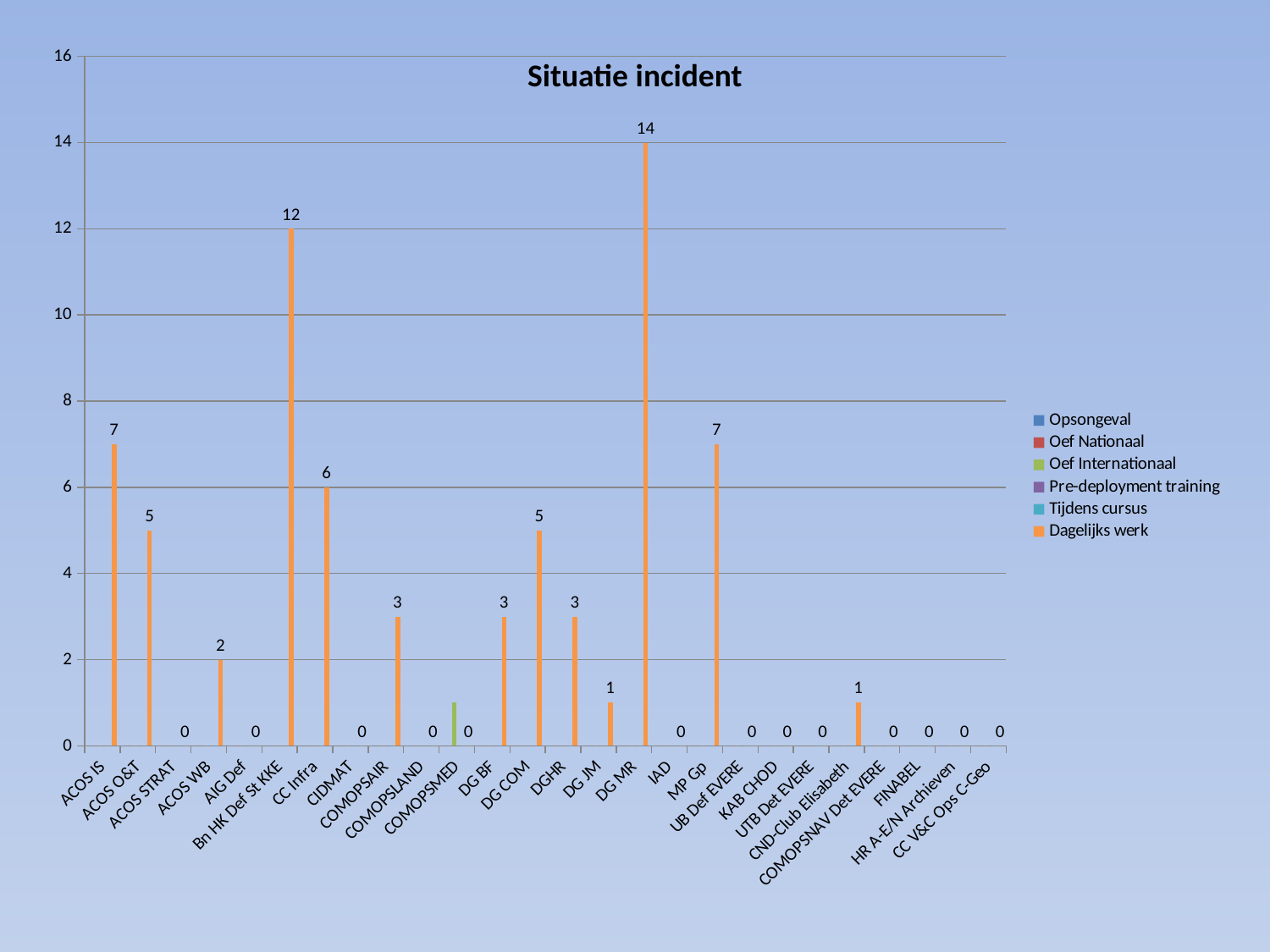
What is the title of the chart? Situatie incident How many categories are shown on the x axis? 26 What is the Dagelijks werk value for Bn HK Def St KKE? 12 Which category has the highest Dagelijks werk value? DG MR Which has the larger Dagelijks werk value, ACOS IS or CC Infra? ACOS IS What is the Dagelijks werk value for DG MR? 14 Which legend entry is shown in orange? Dagelijks werk Is the Oef Internationaal value for COMOPSMED greater or less than 2? less What kind of chart is shown on the slide? bar chart What is the Dagelijks werk value for CC Infra? 6 How many series does the legend list? 6 What is the difference between the Dagelijks werk values for DG MR and Bn HK Def St KKE? 2